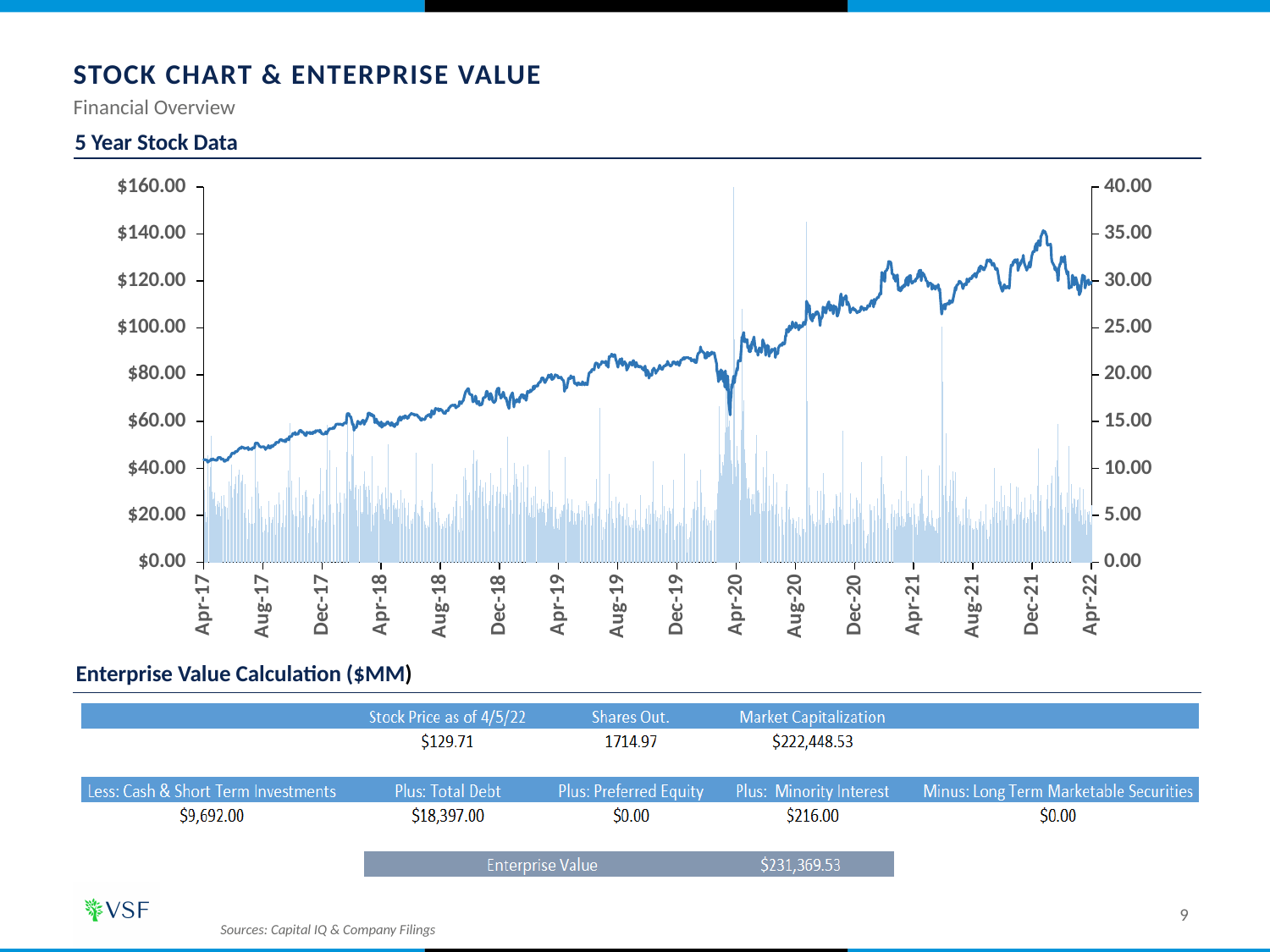
Is the stock price at Aug-18 greater or less than $80.00? less Is the stock price at Apr-22 greater or less than $100.00? greater What is the first date label on the x axis of the stock chart? Apr-17 Is the stock price at Dec-21 greater or less than $120.00? greater What is the title of the chart on the slide? 5 Year Stock Data Does the stock price line generally rise or fall from Apr-17 to Apr-22? Rise What is the highest value shown on the left-hand axis of the stock chart? $160.00 How many date labels are shown on the x axis of the stock chart? 16 What kind of chart is shown under '5 Year Stock Data'? A combination line and bar chart